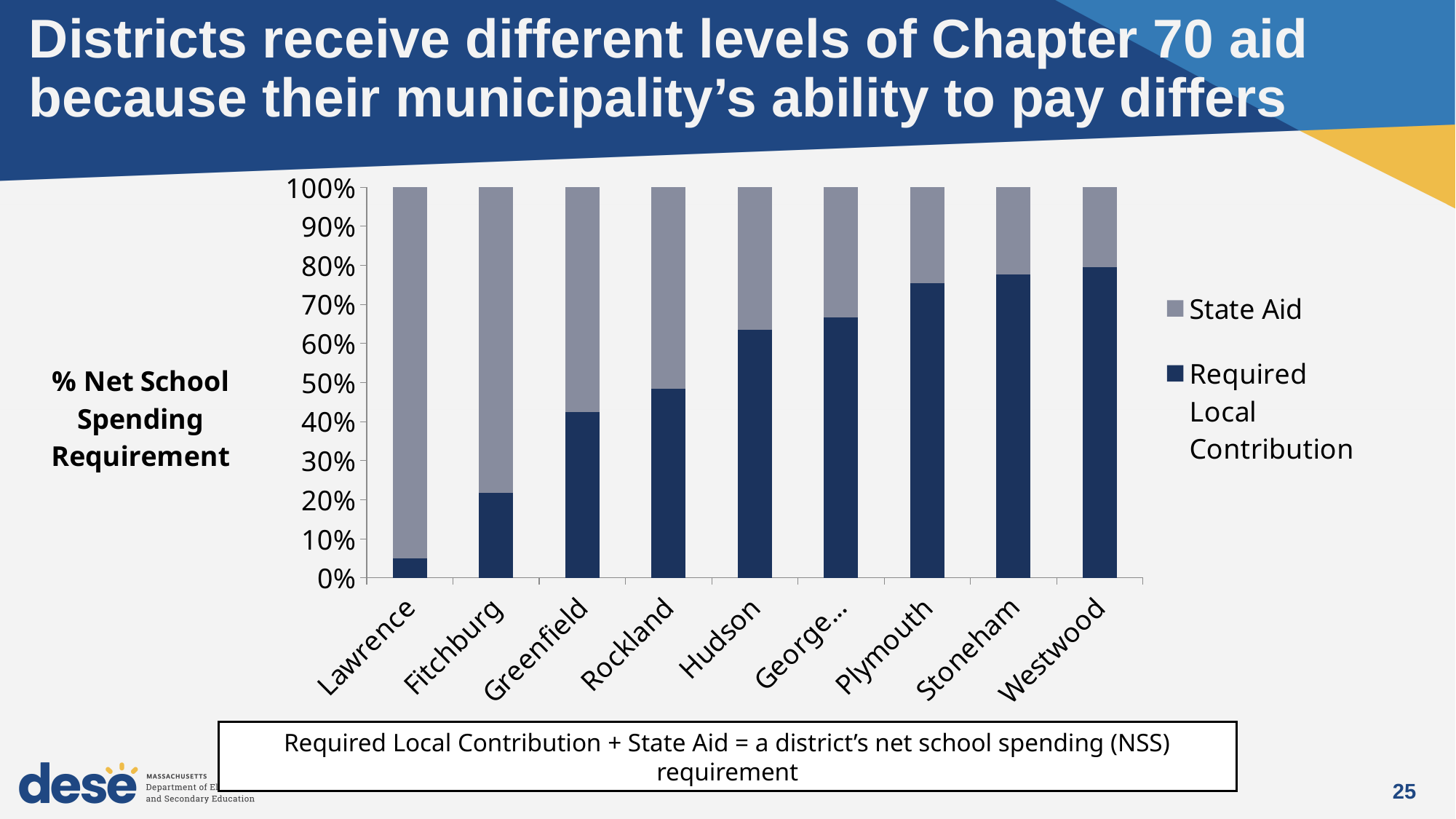
What is the label on the y axis of the chart? % Net School Spending Requirement Is the Required Local Contribution for Greenfield greater or less than 50%? less Does the Required Local Contribution share rise or fall moving from Lawrence to Westwood along the x axis? Rise Which district has a larger Required Local Contribution share, Fitchburg or Hudson? Hudson Which district has the highest State Aid share? Lawrence Is the Required Local Contribution for Plymouth greater or less than 70%? greater How many series does the chart's legend list? 2 What does each stacked bar total? 100% How many districts are shown along the x axis of the chart? 9 Which district has the lowest Required Local Contribution share? Lawrence What kind of chart is shown on the slide? Stacked bar chart Is the Required Local Contribution for Lawrence greater or less than 10%? less